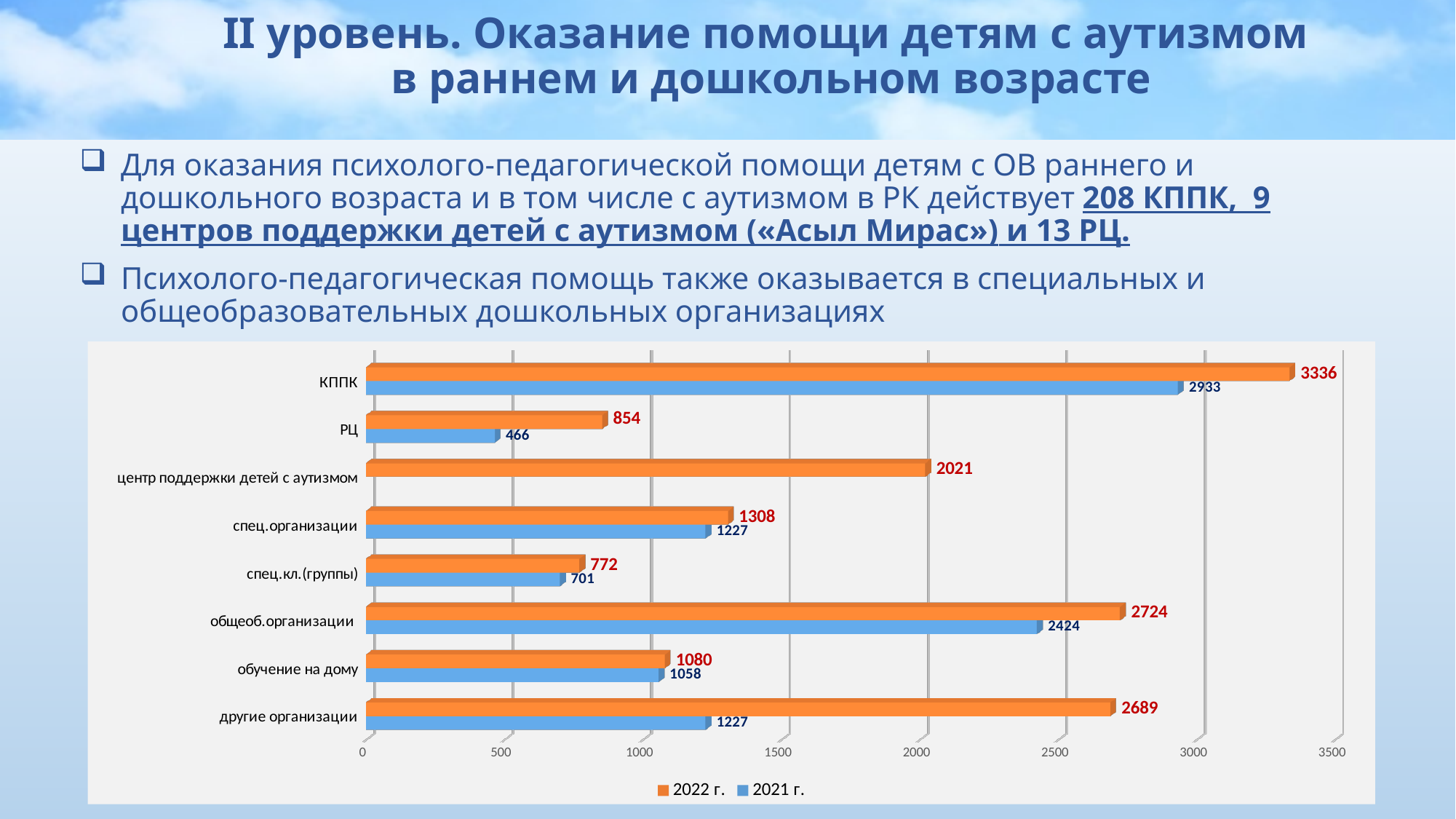
What is the difference between the 2022 г. and 2021 г. values for общеоб.организации? 300 Which is larger for другие организации: the 2022 г. value or the 2021 г. value? 2022 г. Which category has the lowest value in the 2021 г. series? РЦ What is the value for центр поддержки детей с аутизмом in the 2022 г. series? 2021 How many categories are shown on the chart's vertical axis? 8 How many series does the chart legend list? 2 Which category has the highest value in the 2022 г. series? КППК Which colour represents the 2021 г. series in the chart? blue What is the difference between the 2022 г. and 2021 г. values for обучение на дому? 22 What is the value for КППК in the 2022 г. series? 3336 What is the value for РЦ in the 2021 г. series? 466 What type of chart is shown on the slide? bar chart